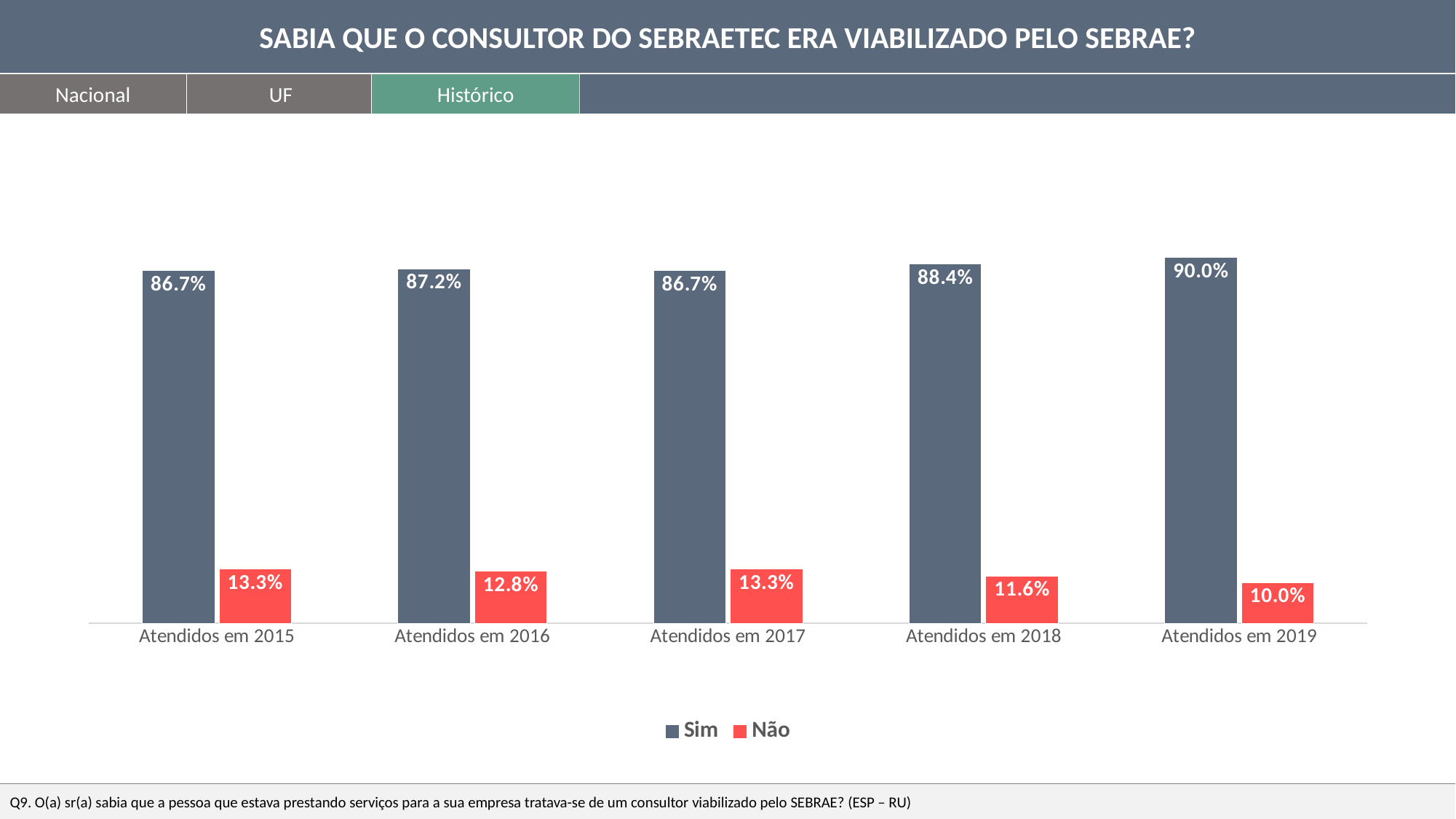
Which category has the lowest 'Não' value? Atendidos em 2019 What is the value of the 'Não' bar for 'Atendidos em 2016'? 12.8% What is the difference between the 'Sim' values for 'Atendidos em 2019' and 'Atendidos em 2015'? 3.3% How many series does the legend list? 2 Which category has the highest 'Sim' value? Atendidos em 2019 Which is larger: the 'Não' value for 'Atendidos em 2017' or for 'Atendidos em 2018'? Atendidos em 2017 What is the difference between the 'Sim' and 'Não' values for 'Atendidos em 2018'? 76.8% What is the value of the 'Sim' bar for 'Atendidos em 2018'? 88.4% Does the 'Não' series generally rise or fall from 'Atendidos em 2015' to 'Atendidos em 2019'? Fall What is the value of the 'Sim' bar for 'Atendidos em 2019'? 90.0% How many categories are shown on the x axis? 5 What kind of chart is shown on the slide? Bar chart